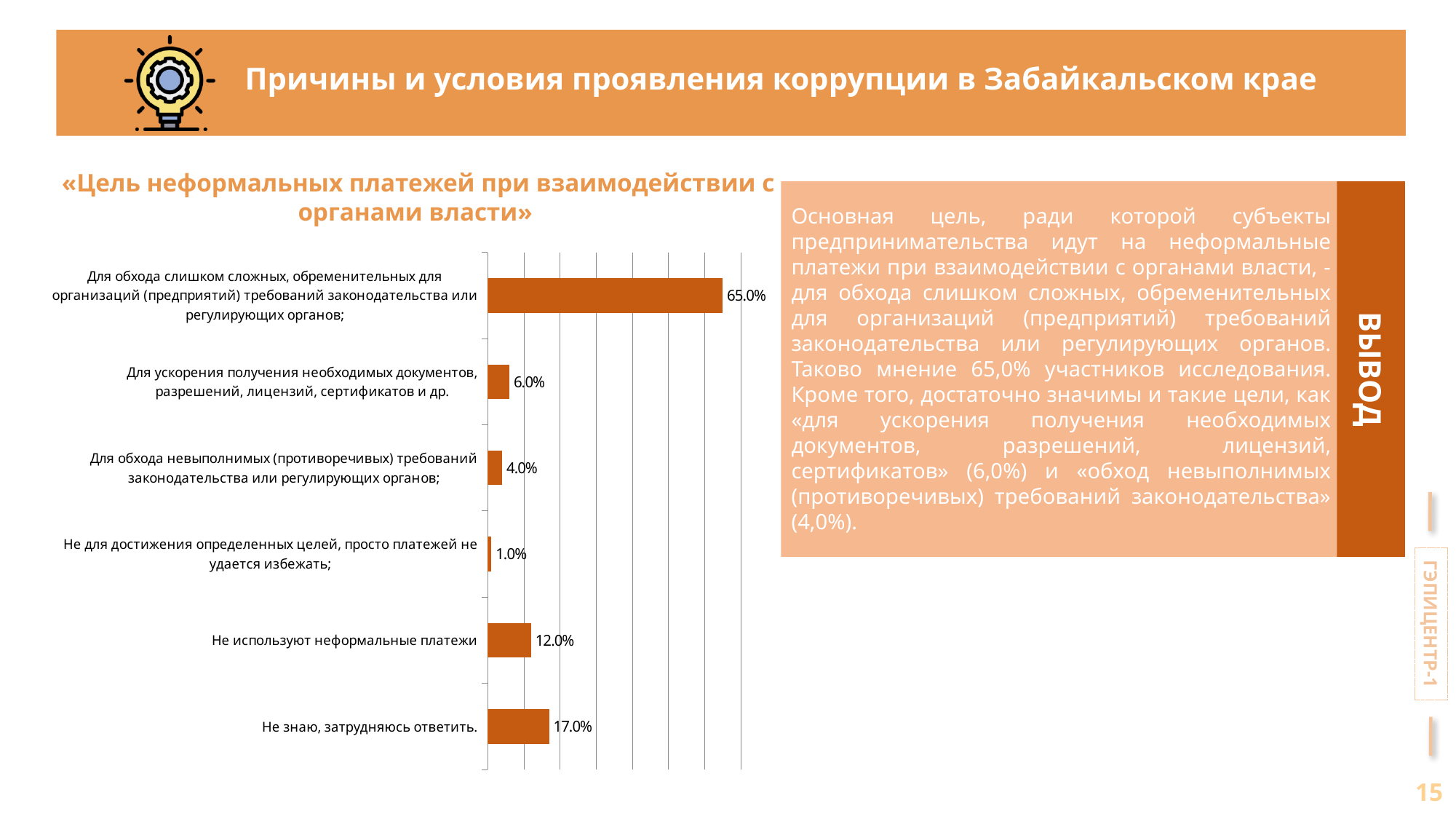
What is the difference between the highest value and the value for «Для ускорения получения необходимых документов, разрешений, лицензий, сертификатов и др.»? 59.0% Which category has the highest value? Для обхода слишком сложных, обременительных для организаций (предприятий) требований законодательства или регулирующих органов; Which is larger: the value for «Для обхода невыполнимых (противоречивых) требований законодательства или регулирующих органов;» or the value for «Для ускорения получения необходимых документов, разрешений, лицензий, сертификатов и др.»? Для ускорения получения необходимых документов, разрешений, лицензий, сертификатов и др. What value is shown for «Не для достижения определенных целей, просто платежей не удается избежать;»? 1.0% What value is shown for «Не знаю, затрудняюсь ответить.»? 17.0% What value is shown for «Не используют неформальные платежи»? 12.0% Which category has the lowest value? Не для достижения определенных целей, просто платежей не удается избежать; What is the title of the chart? «Цель неформальных платежей при взаимодействии с органами власти» What is the difference between the value for «Не знаю, затрудняюсь ответить.» and the value for «Не используют неформальные платежи»? 5.0% What value is shown for «Для ускорения получения необходимых документов, разрешений, лицензий, сертификатов и др.»? 6.0% What kind of chart is shown on the slide? Bar chart How many categories are shown in the chart? 6